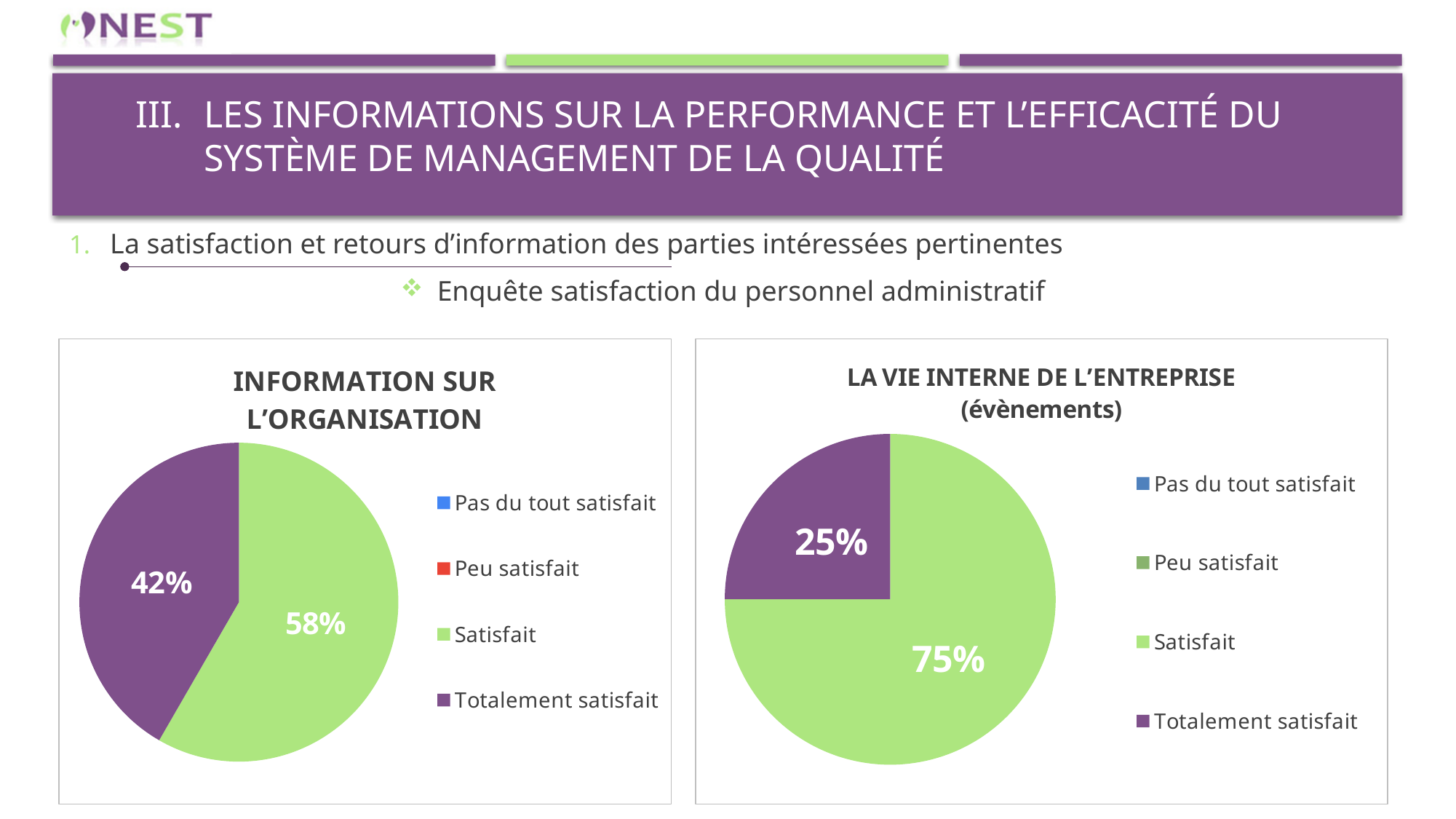
In the 'INFORMATION SUR L'ORGANISATION' chart, what share is labelled for Totalement satisfait? 42% In the 'INFORMATION SUR L'ORGANISATION' chart, what colour is the Totalement satisfait slice? Purple In the 'LA VIE INTERNE DE L'ENTREPRISE (évènements)' chart, which category has the largest slice? Satisfait Is the Satisfait share larger in the 'INFORMATION SUR L'ORGANISATION' chart or in the 'LA VIE INTERNE DE L'ENTREPRISE (évènements)' chart? LA VIE INTERNE DE L'ENTREPRISE (évènements) In the 'LA VIE INTERNE DE L'ENTREPRISE (évènements)' chart, what share is labelled for Totalement satisfait? 25% In the 'LA VIE INTERNE DE L'ENTREPRISE (évènements)' chart, what share is labelled for Satisfait? 75% In the 'INFORMATION SUR L'ORGANISATION' chart, which category has the largest slice? Satisfait In the 'LA VIE INTERNE DE L'ENTREPRISE (évènements)' chart, what is the difference between the Satisfait and Totalement satisfait shares? 50% In the 'INFORMATION SUR L'ORGANISATION' chart, what is the difference between the Satisfait and Totalement satisfait shares? 16% What type of chart is the 'INFORMATION SUR L'ORGANISATION' chart? Pie chart In the 'INFORMATION SUR L'ORGANISATION' chart, what share is labelled for Satisfait? 58% How many entries does the legend of the 'LA VIE INTERNE DE L'ENTREPRISE (évènements)' chart list? 4